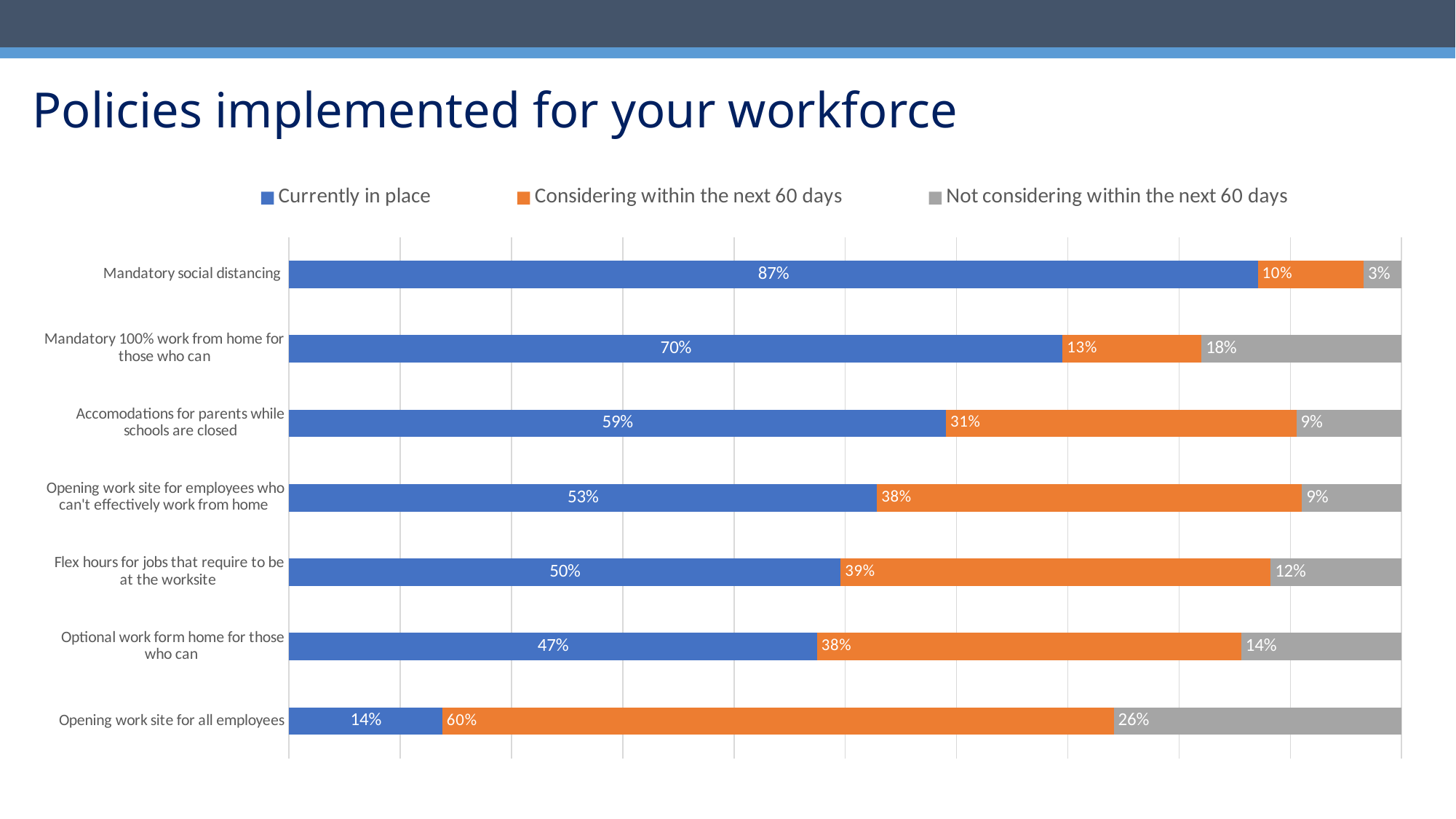
What is the difference between the 'Currently in place' values for 'Mandatory social distancing' and 'Mandatory 100% work from home for those who can'? 17% Which policy has the lowest 'Currently in place' value? Opening work site for all employees What percentage of respondents report 'Mandatory social distancing' as currently in place? 87% What is the 'Not considering within the next 60 days' value for 'Mandatory 100% work from home for those who can'? 18% What is the 'Considering within the next 60 days' value for 'Opening work site for all employees'? 60% How many policies are listed on the chart? 7 Which policy has the highest 'Currently in place' value? Mandatory social distancing How many series does the legend list? 3 What is the total of the stacked bar for 'Mandatory social distancing'? 100% What kind of chart is shown on the slide? Stacked bar chart Which colour represents 'Not considering within the next 60 days' in the legend? Grey Which is larger: the 'Considering within the next 60 days' value for 'Flex hours for jobs that require to be at the worksite' or for 'Accomodations for parents while schools are closed'? Flex hours for jobs that require to be at the worksite